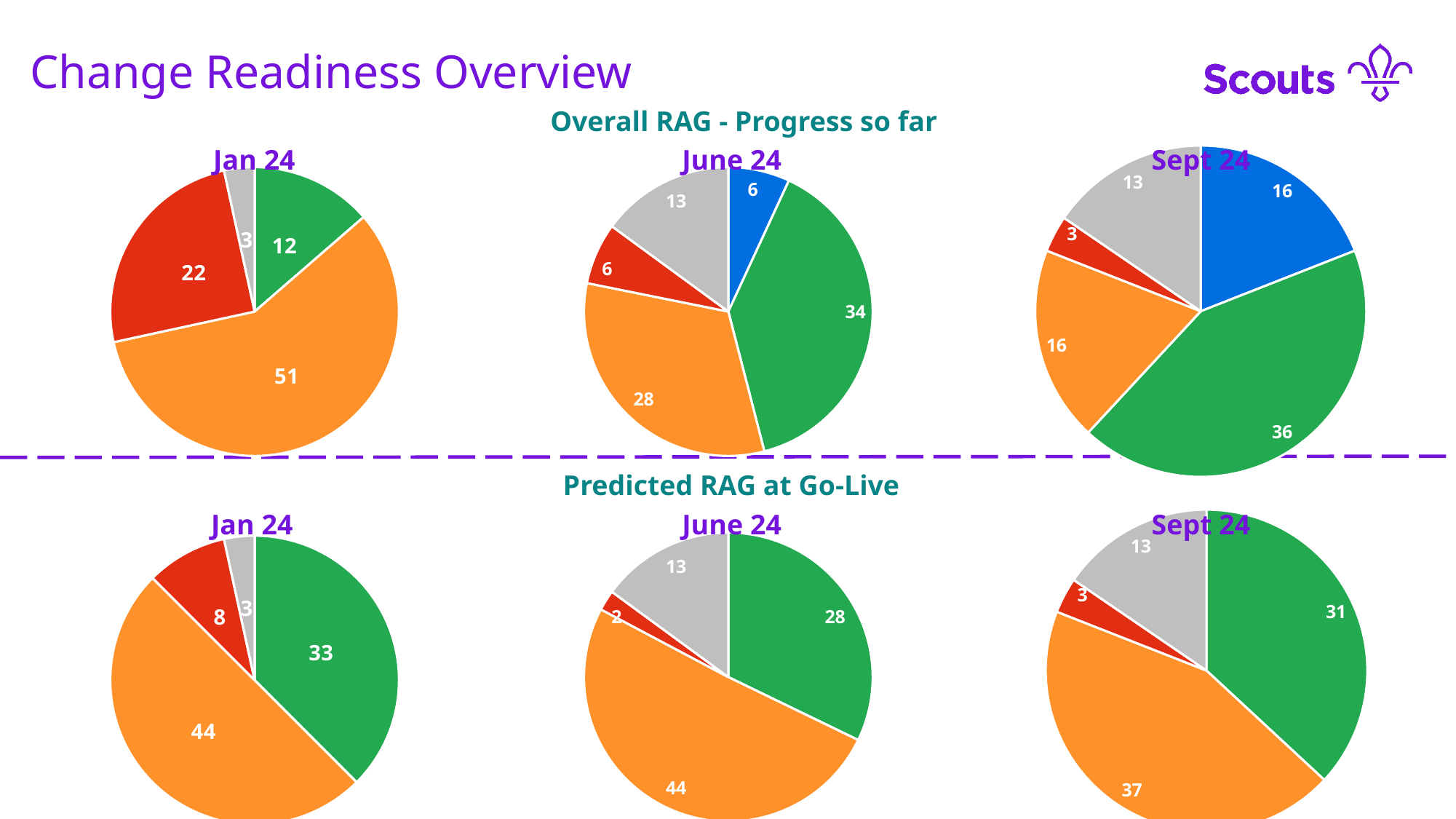
In the 'Overall RAG - Progress so far' Sept 24 pie chart, what value is shown for the blue slice? 16 In the 'Overall RAG - Progress so far' Sept 24 pie chart, which colour slice is the largest? Green What is the total of all slices in the 'Predicted RAG at Go-Live' Jan 24 pie chart? 88 In the 'Predicted RAG at Go-Live' Jan 24 pie chart, which colour slice is the smallest? Grey In the 'Overall RAG - Progress so far' June 24 pie chart, what value is shown for the green slice? 34 How many pie charts are shown on the slide? 6 In the 'Overall RAG - Progress so far' Jan 24 pie chart, what value is shown for the orange slice? 51 In the 'Overall RAG - Progress so far' Jan 24 pie chart, what is the difference between the orange slice and the red slice? 29 In the 'Predicted RAG at Go-Live' June 24 pie chart, what value is shown for the red slice? 2 How many slices does the 'Overall RAG - Progress so far' June 24 pie chart have? 5 In the 'Predicted RAG at Go-Live' Sept 24 pie chart, is the orange slice or the green slice larger? Orange What type of chart is used on this slide? Pie chart